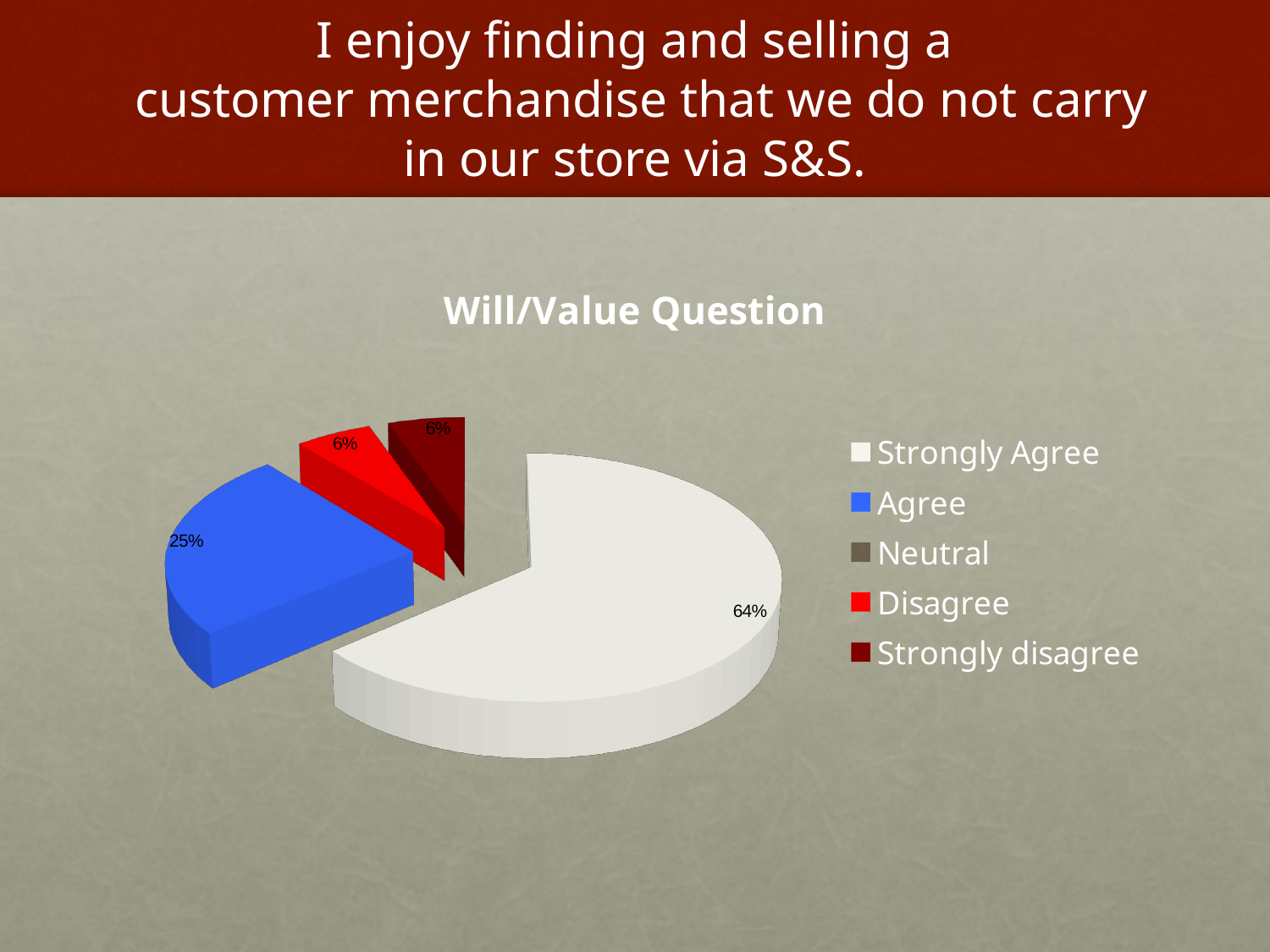
What is the title of the chart? Will/Value Question What percentage of responses are Disagree? 6% Is the share for Agree greater or less than 50%? less Which response category has the largest share of the pie? Strongly Agree What is the difference in percentage points between the Strongly Agree share and the Agree share? 39 What percentage of responses are Strongly Agree? 64% How many categories does the legend list? 5 What colour is the Agree slice? blue What kind of chart is shown on the slide? pie chart Which is larger, the share for Strongly Agree or the share for Agree? Strongly Agree What percentage of responses are Agree? 25% What percentage of responses are Strongly disagree? 6%